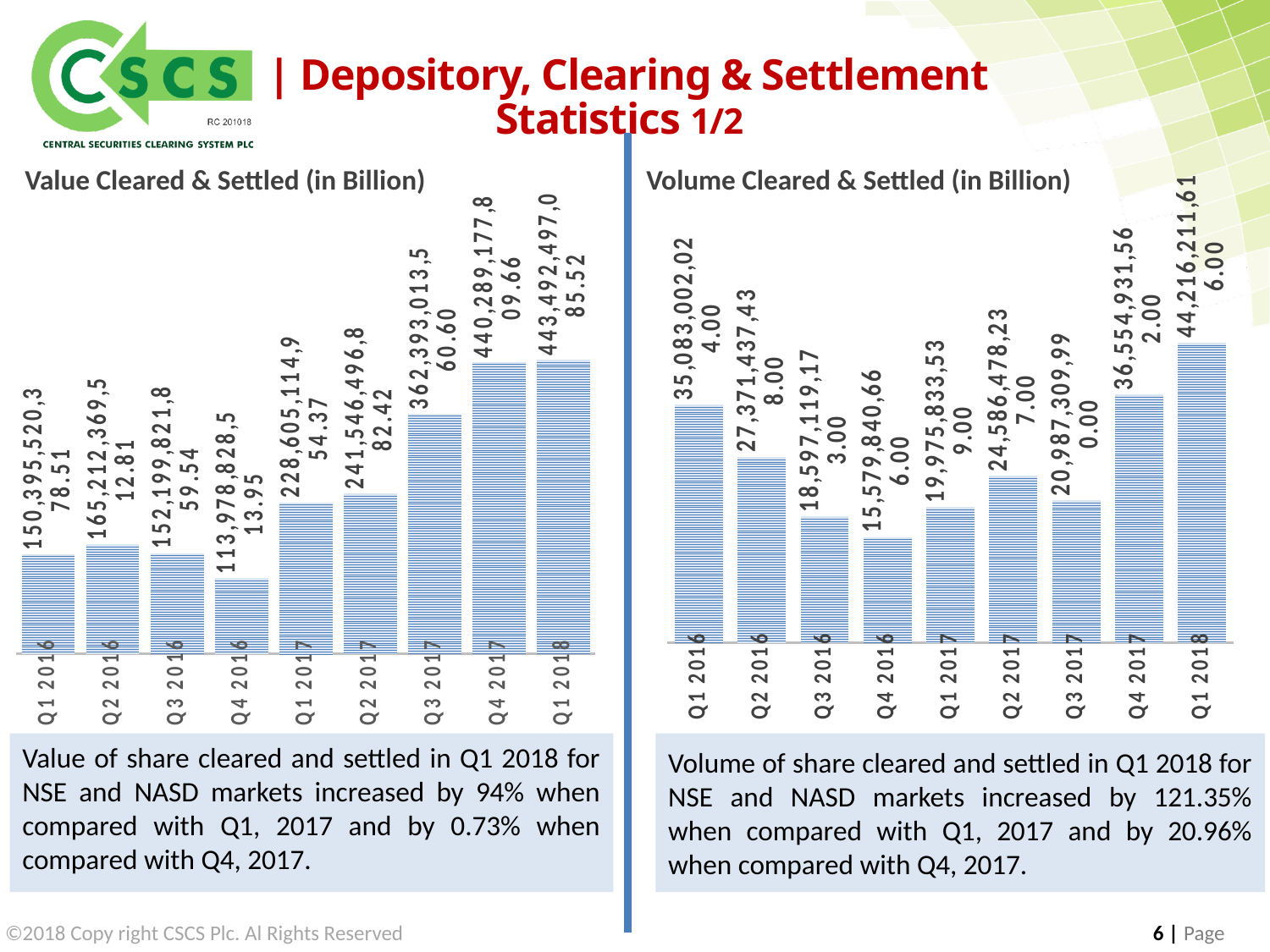
On the Volume Cleared & Settled chart, what is the difference between Q1 2018 and Q4 2017? 7,661,280,054.00 What type of chart is the Volume Cleared & Settled chart? Bar chart How many quarters are shown on the Value Cleared & Settled chart? 9 On the Value Cleared & Settled chart, which quarter has the lowest value? Q4 2016 On the Value Cleared & Settled chart, which is larger, Q2 2016 or Q3 2016? Q2 2016 On the Volume Cleared & Settled chart, what is the value for Q4 2017? 36,554,931,562.00 On the Value Cleared & Settled chart, do the values rise or fall from Q4 2016 to Q1 2018? Rise On the Volume Cleared & Settled chart, which quarter has the lowest value? Q4 2016 On the Value Cleared & Settled chart, what is the value for Q1 2018? 443,492,497,085.52 On the Volume Cleared & Settled chart, what is the value for Q1 2016? 35,083,002,024.00 On the Value Cleared & Settled chart, what is the value for Q4 2016? 113,978,828,513.95 On the Volume Cleared & Settled chart, which quarter has the highest value? Q1 2018